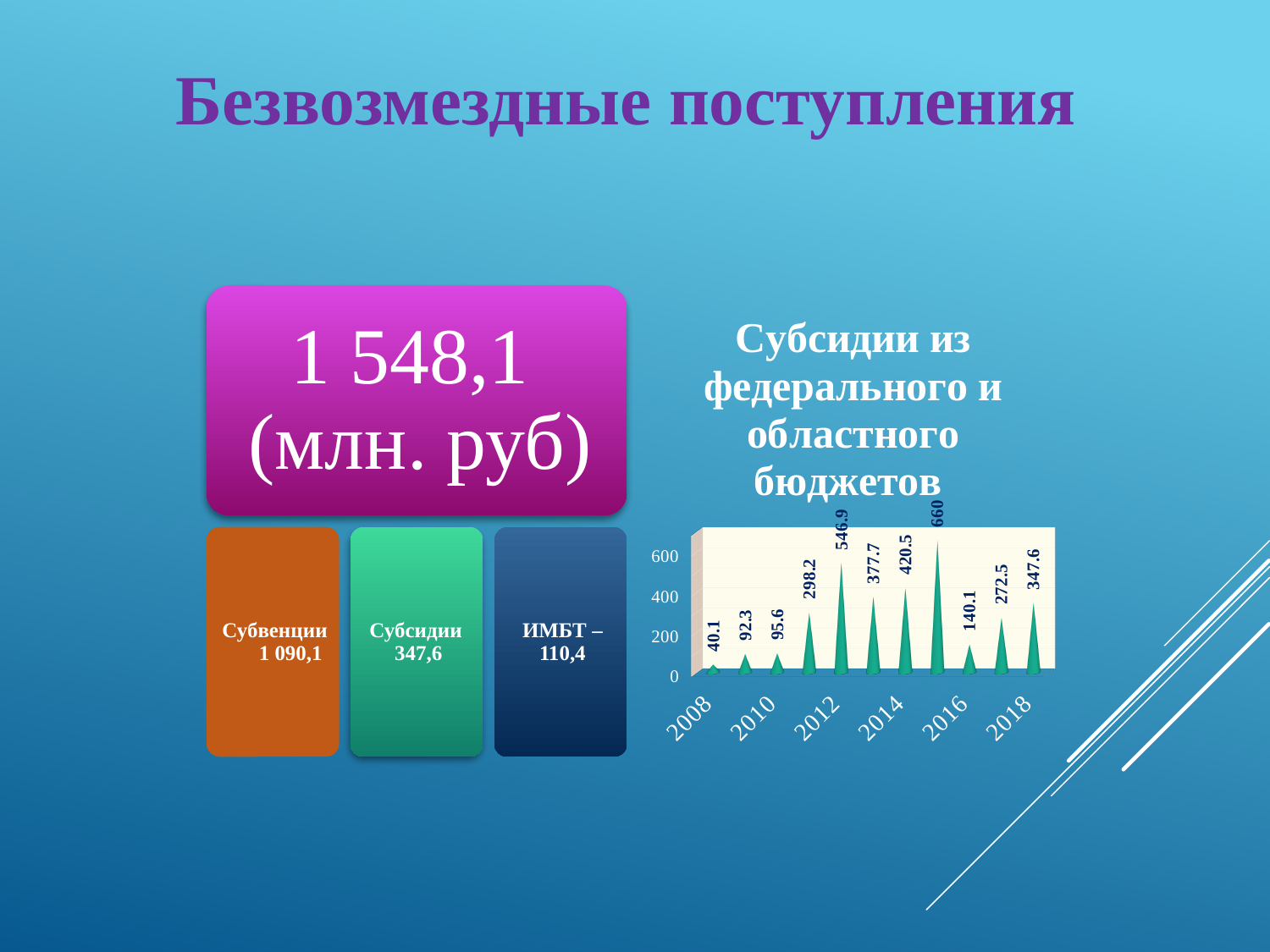
How many bars are plotted in the chart? 11 What type of chart is shown on the slide? bar chart What is the value for 2018 in the chart? 347.6 What is the value for 2016 in the chart? 140.1 What is the value for 2012 in the chart? 546.9 What is the title of the chart on the slide? Субсидии из федерального и областного бюджетов What is the difference between the values for 2012 and 2010? 451.3 Do the values rise or fall from 2008 to 2012? rise What is the value for 2008 in the chart? 40.1 What is the highest value shown in the chart? 660 Which year has the lowest value in the chart? 2008 Which is larger, the value for 2014 or the value for 2018? 2014